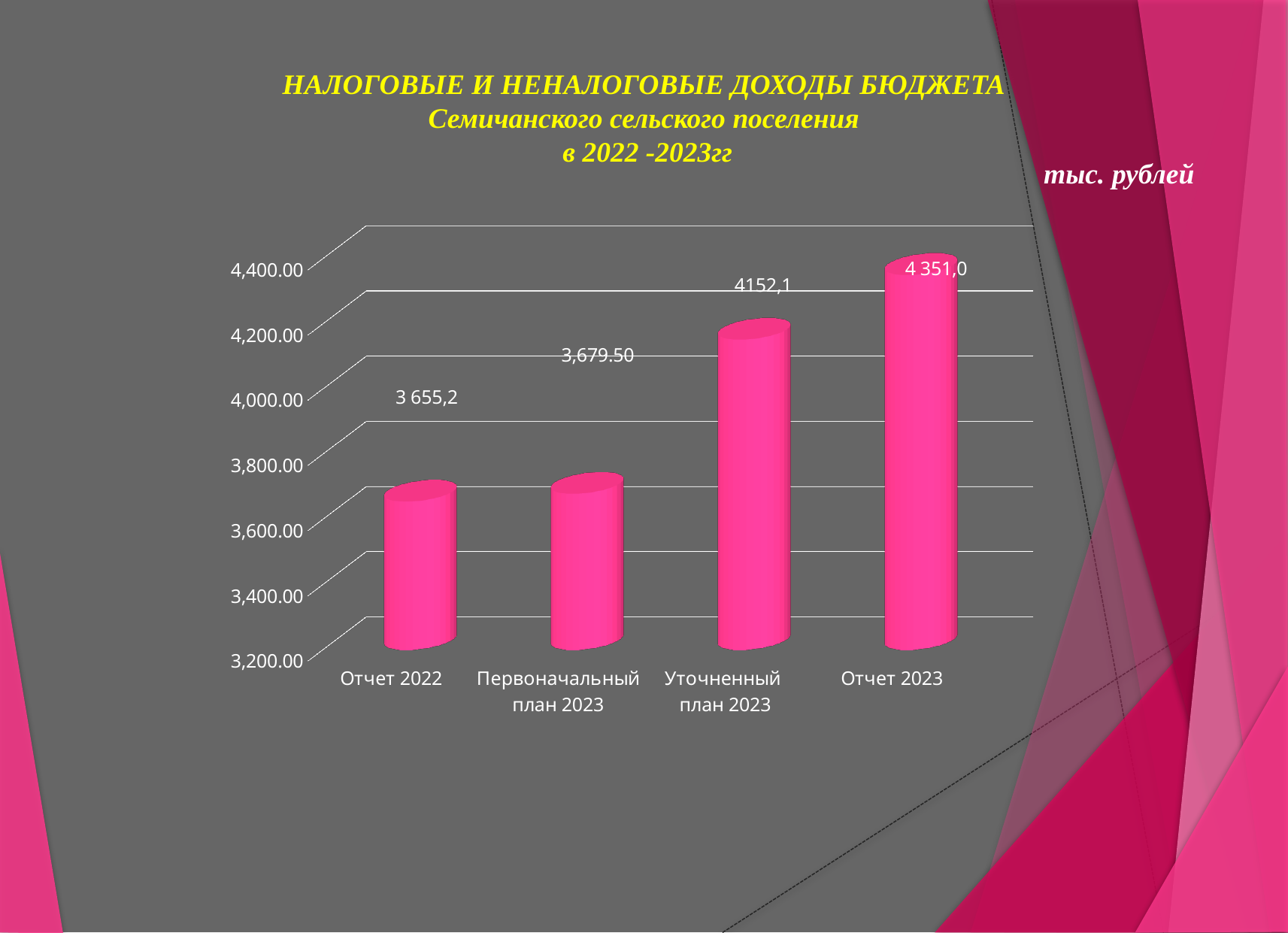
Which category has the highest value? Отчет 2023 What kind of chart is shown on the slide? Bar chart Do the values rise or fall from left to right along the x axis? Rise What is the value for Отчет 2023? 4 351,0 What is the value for Отчет 2022? 3 655,2 Which is larger, Уточненный план 2023 or Первоначальный план 2023? Уточненный план 2023 What is the value for Уточненный план 2023? 4152,1 What is the difference between Отчет 2023 and Отчет 2022? 695,8 What is the difference between Отчет 2023 and Уточненный план 2023? 198,9 What is the value for Первоначальный план 2023? 3,679.50 Which category has the lowest value? Отчет 2022 How many categories are shown on the chart? 4